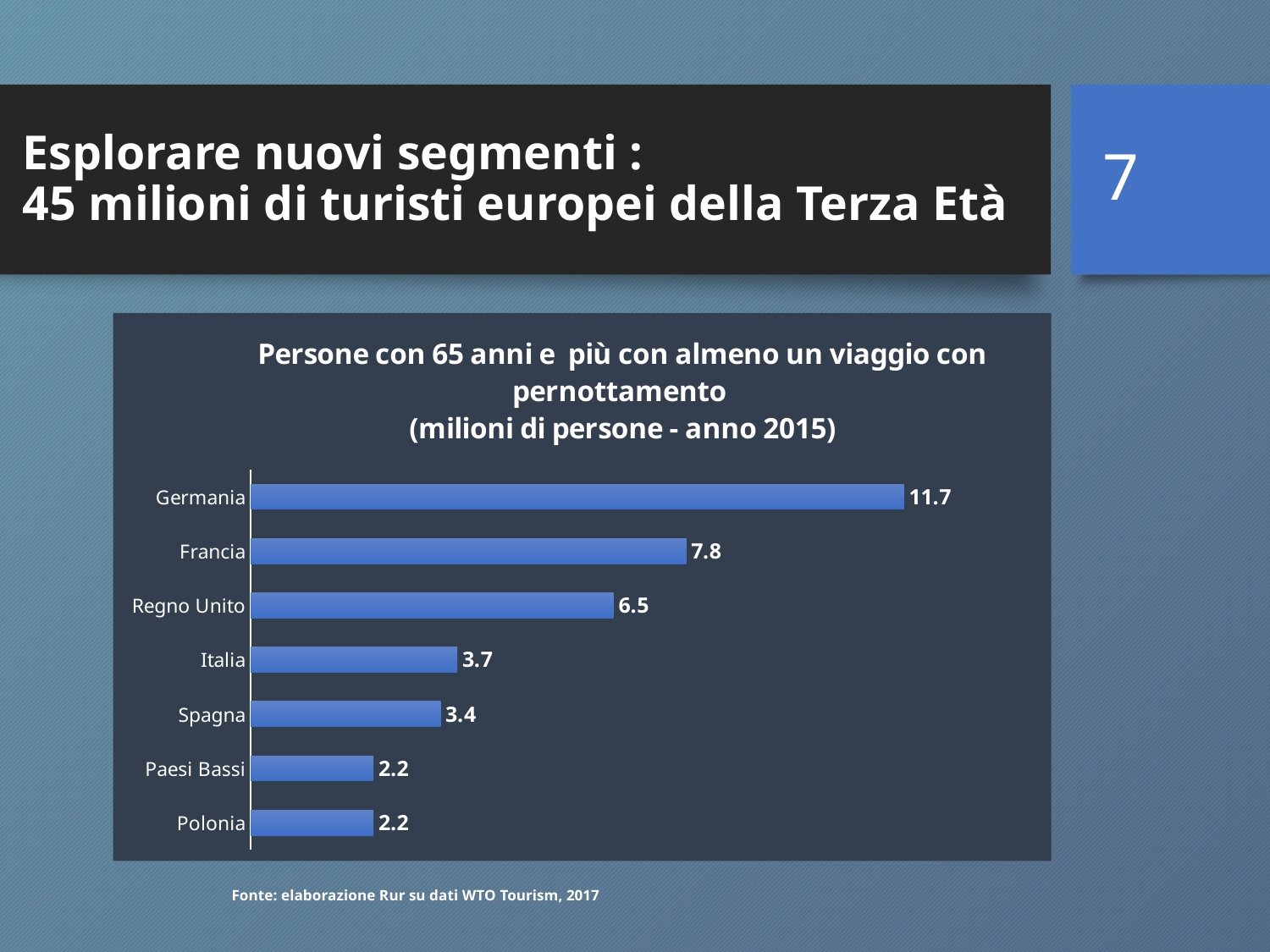
What year does the chart title say the data refers to? 2015 What is the value for Germania? 11.7 How many countries are shown in the chart? 7 Which country has the highest value? Germania What is the difference between the values for Italia and Spagna? 0.3 Which is larger, the value for Francia or the value for Regno Unito? Francia Which two countries share the same value of 2.2? Paesi Bassi and Polonia What is the value for Regno Unito? 6.5 What kind of chart is shown on the slide? Bar chart What is the difference between the values for Germania and Francia? 3.9 What unit does the chart title say the values are in? milioni di persone What is the value for Spagna? 3.4